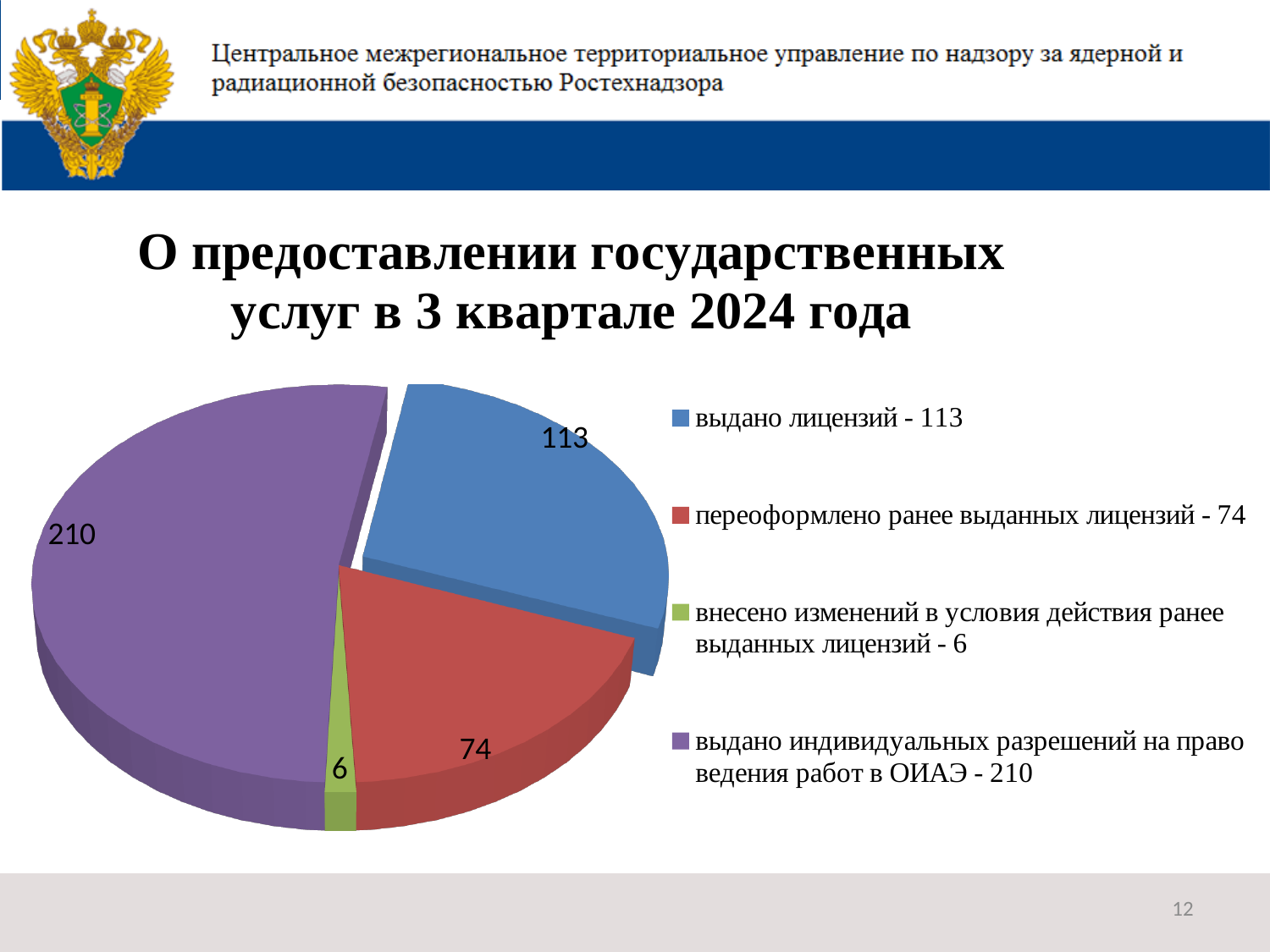
What is the difference between the value for "выдано индивидуальных разрешений на право ведения работ в ОИАЭ" and the value for "выдано лицензий"? 97 What is the value for "внесено изменений в условия действия ранее выданных лицензий"? 6 What kind of chart is shown on the slide? Pie chart What is the value for "выдано лицензий"? 113 Which category has the largest slice of the pie? выдано индивидуальных разрешений на право ведения работ в ОИАЭ Which is larger: the value for "выдано лицензий" or the value for "переоформлено ранее выданных лицензий"? выдано лицензий What is the value for "выдано индивидуальных разрешений на право ведения работ в ОИАЭ"? 210 What colour is the slice for "выдано лицензий"? Blue How many entries does the legend list? 4 Which category has the smallest slice of the pie? внесено изменений в условия действия ранее выданных лицензий What is the value for "переоформлено ранее выданных лицензий"? 74 How many slices does the pie chart have? 4